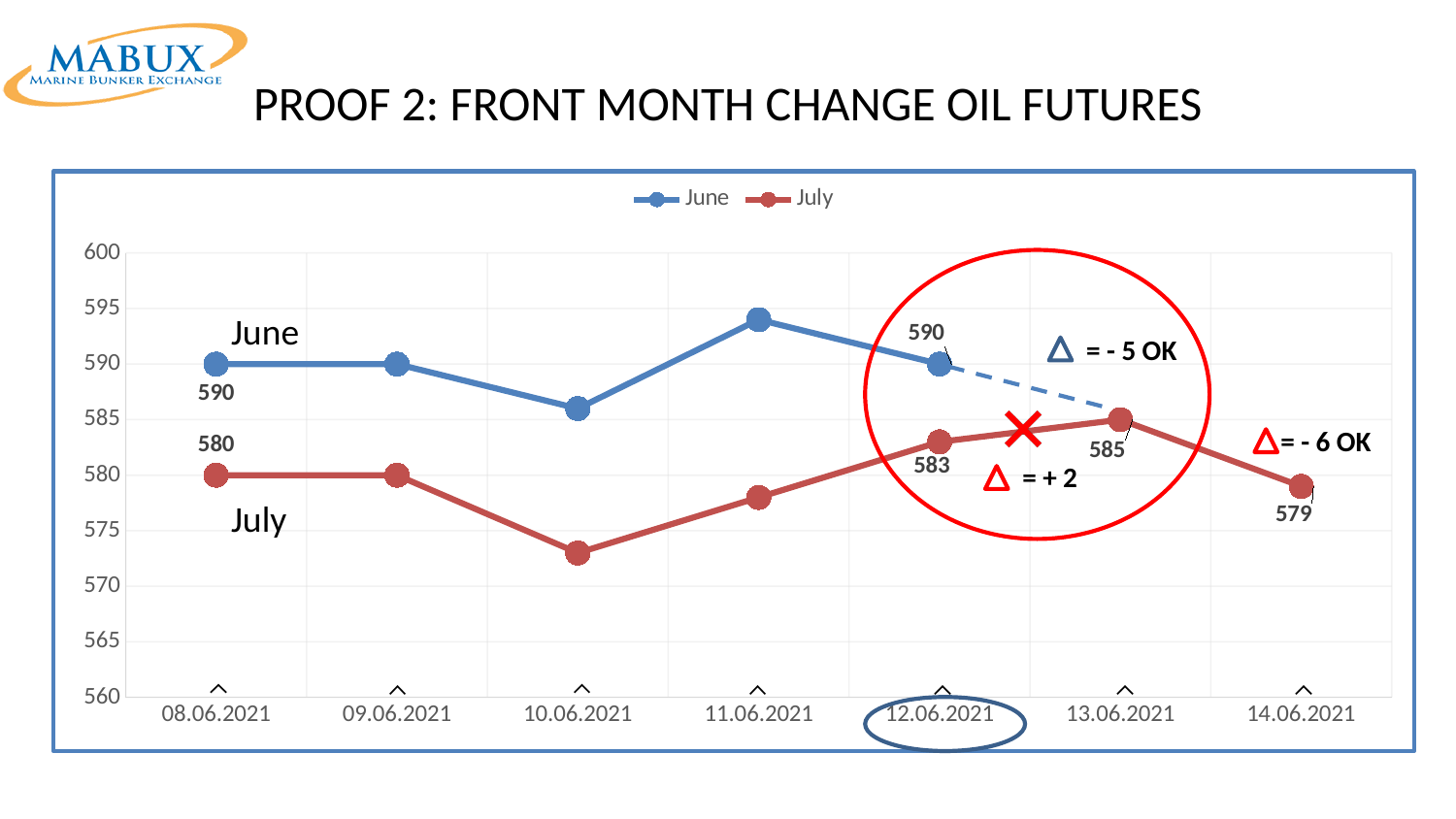
What kind of chart is shown on the slide? line chart What is the value of the July series on 12.06.2021? 583 How many dates are shown on the x axis? 7 Is the value of the June series on 11.06.2021 greater or less than 590? greater On which date does the July series reach its lowest value? 10.06.2021 What is the difference between the June and July values on 08.06.2021? 10 Which series has the higher value on 12.06.2021, June or July? June How many series does the legend list? 2 What is the value of the June series on 12.06.2021? 590 What is the value of the July series on 13.06.2021? 585 What is the value of the July series on 14.06.2021? 579 Is the value of the July series on 10.06.2021 greater or less than 575? less